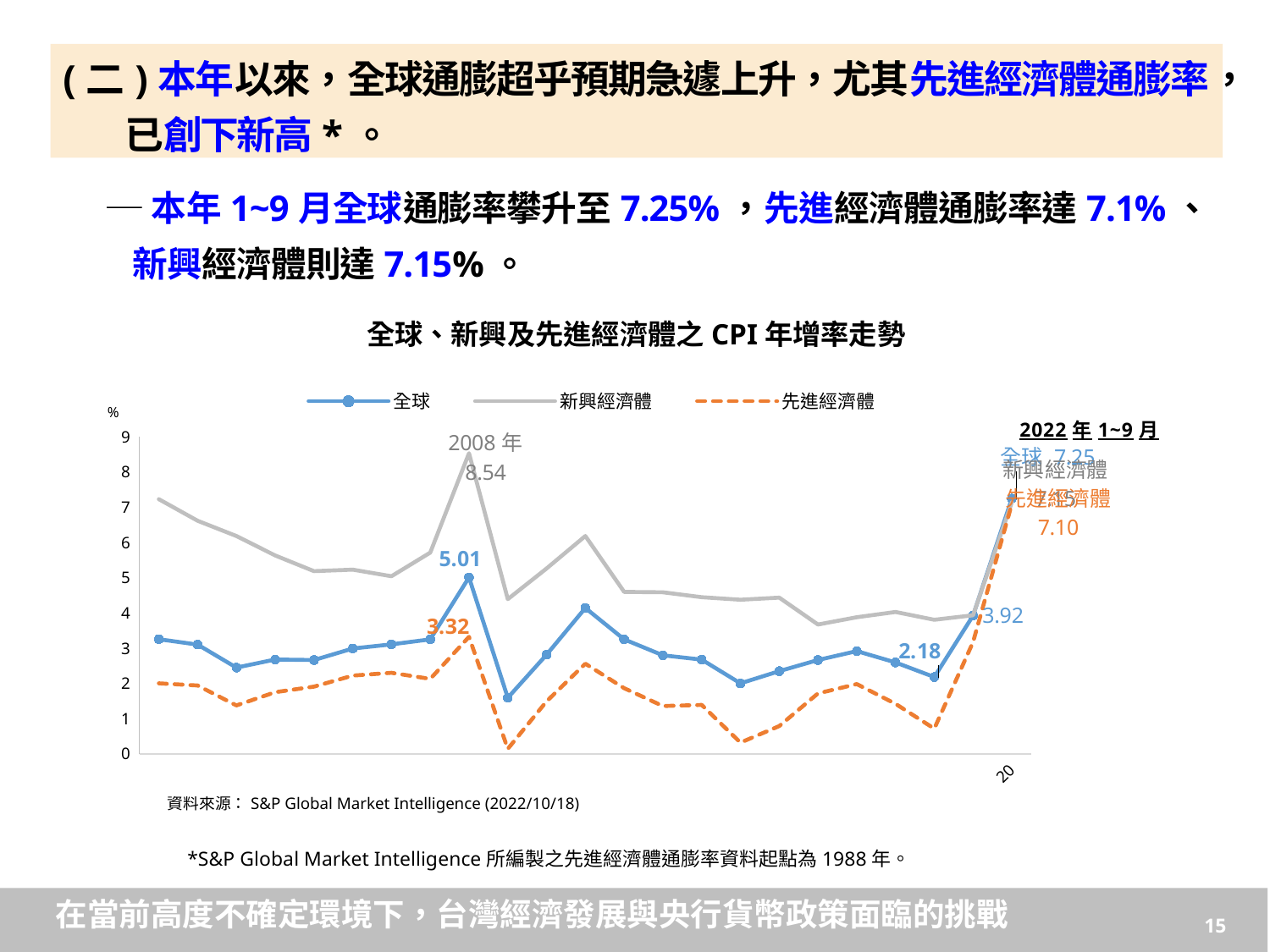
What is the 先進經濟體 CPI annual growth rate for 2022年1~9月? 7.10 Which series is drawn with a dashed line? 先進經濟體 In 2008, which was larger: the 全球 value or the 先進經濟體 value? 全球 What was the CPI annual growth rate for 全球 in 2008? 5.01 How many series does the chart legend list? 3 What was the CPI annual growth rate for 新興經濟體 in 2008? 8.54 What kind of chart is shown on the slide? line chart What is the title of the chart? 全球、新興及先進經濟體之CPI年增率走勢 In 2008, how much higher was the 新興經濟體 value than the 全球 value? 3.53 What was the CPI annual growth rate for 先進經濟體 in 2008? 3.32 In 2008, how much higher was the 全球 value than the 先進經濟體 value? 1.69 What is the 全球 CPI annual growth rate for 2022年1~9月? 7.25